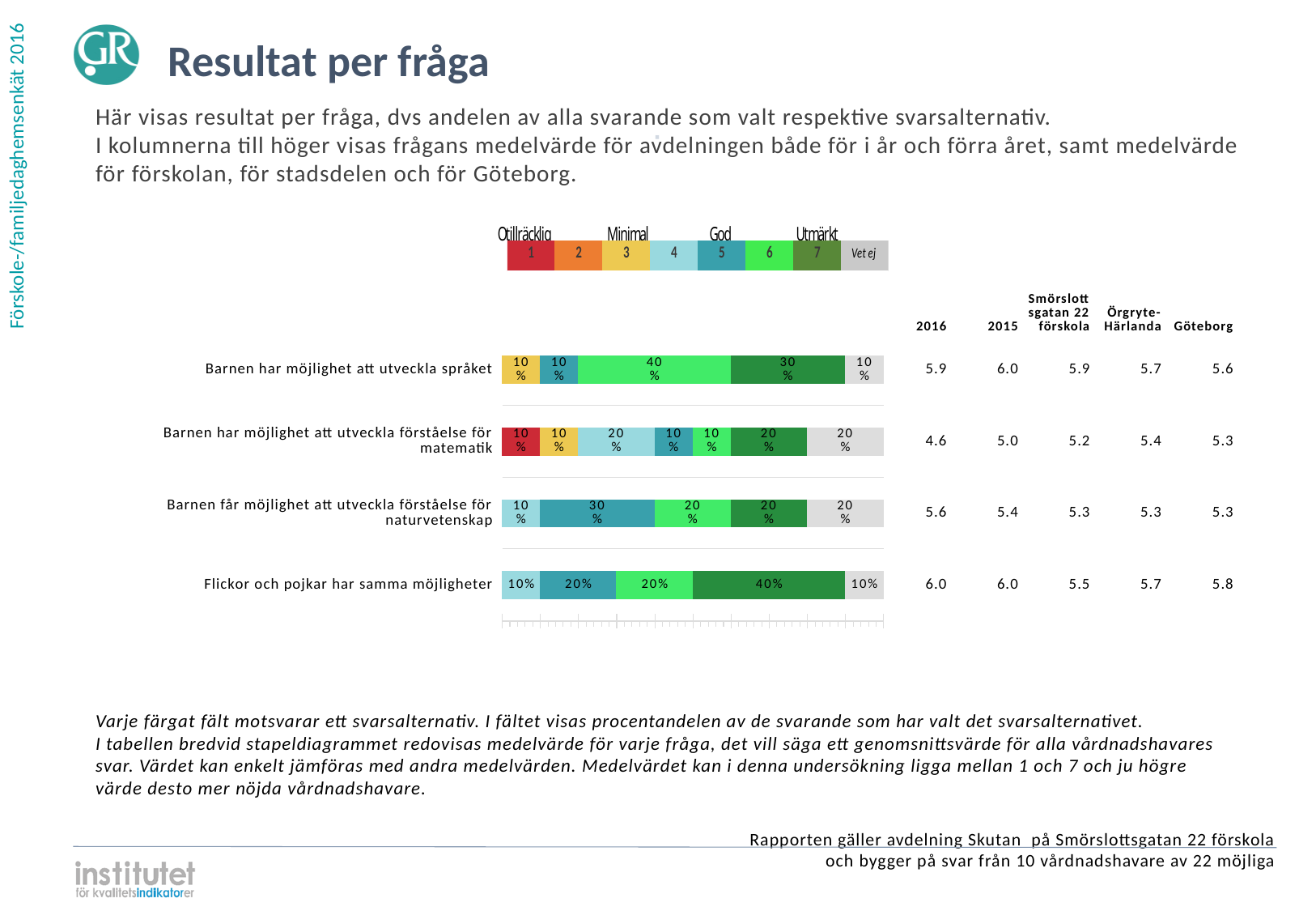
What is the 2016 mean value shown for 'Barnen har möjlighet att utveckla förståelse för matematik'? 4.6 How many response options does the colour legend above the chart list? 8 What percentage of respondents answered 'Vet ej' for 'Barnen har möjlighet att utveckla förståelse för matematik'? 20% What label does the legend give to response option 7? Utmärkt What is the difference between the option 7 share for 'Flickor och pojkar har samma möjligheter' (40%) and the option 7 share for 'Barnen har möjlighet att utveckla förståelse för matematik' (20%)? 20 percentage points What percentage of respondents chose option 7 (dark green) for 'Flickor och pojkar har samma möjligheter'? 40% What kind of chart is shown on the slide? Stacked bar chart What percentage of respondents chose option 6 (light green) for 'Barnen har möjlighet att utveckla språket'? 40% What is the total of all segments in the bar for 'Barnen har möjlighet att utveckla språket'? 100% Which response option has the largest share for 'Barnen får möjlighet att utveckla förståelse för naturvetenskap'? 5 (30%) How many questions (categories) are plotted as bars in the chart? 4 Which bar has a larger option 7 (dark green) share: 'Barnen har möjlighet att utveckla språket' or 'Barnen får möjlighet att utveckla förståelse för naturvetenskap'? Barnen har möjlighet att utveckla språket